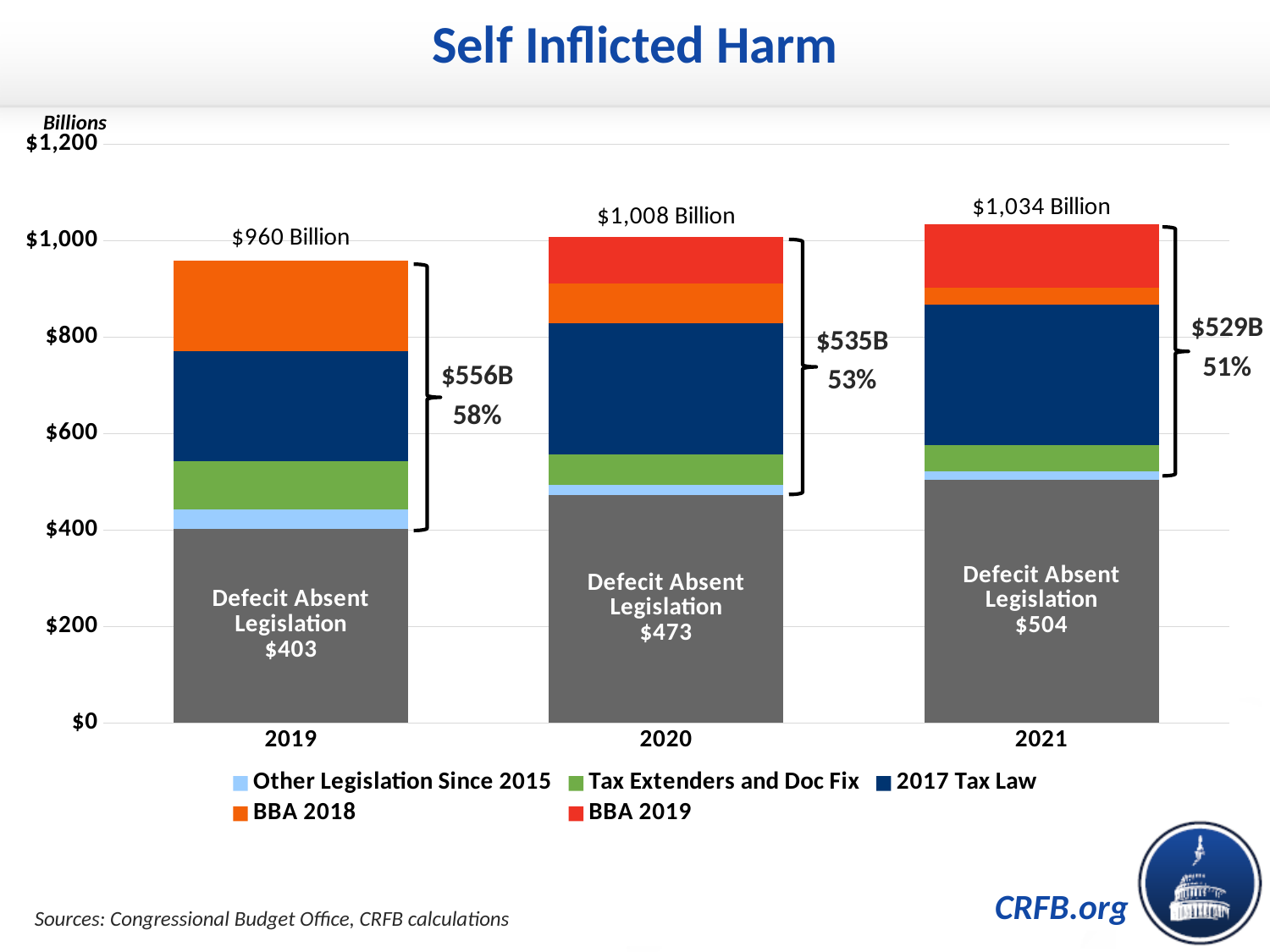
What is the dollar amount of the legislation portion for 2020, as shown by the bracket label? $535B Which is larger, the Deficit Absent Legislation in 2019 or in 2021? 2021 What is the value of Deficit Absent Legislation for 2020? $473 What share of the 2019 deficit is attributed to legislation, according to the bracket label? 58% Which year has the lowest total deficit? 2019 How many series does the legend list? 5 How many years are shown on the x axis? 3 What is the difference between the total deficit in 2021 and in 2019? $74 Billion What kind of chart is shown on the slide? Stacked bar chart What is the total deficit shown for 2021? $1,034 Billion Which year has the highest total deficit? 2021 What is the total deficit shown for 2019? $960 Billion